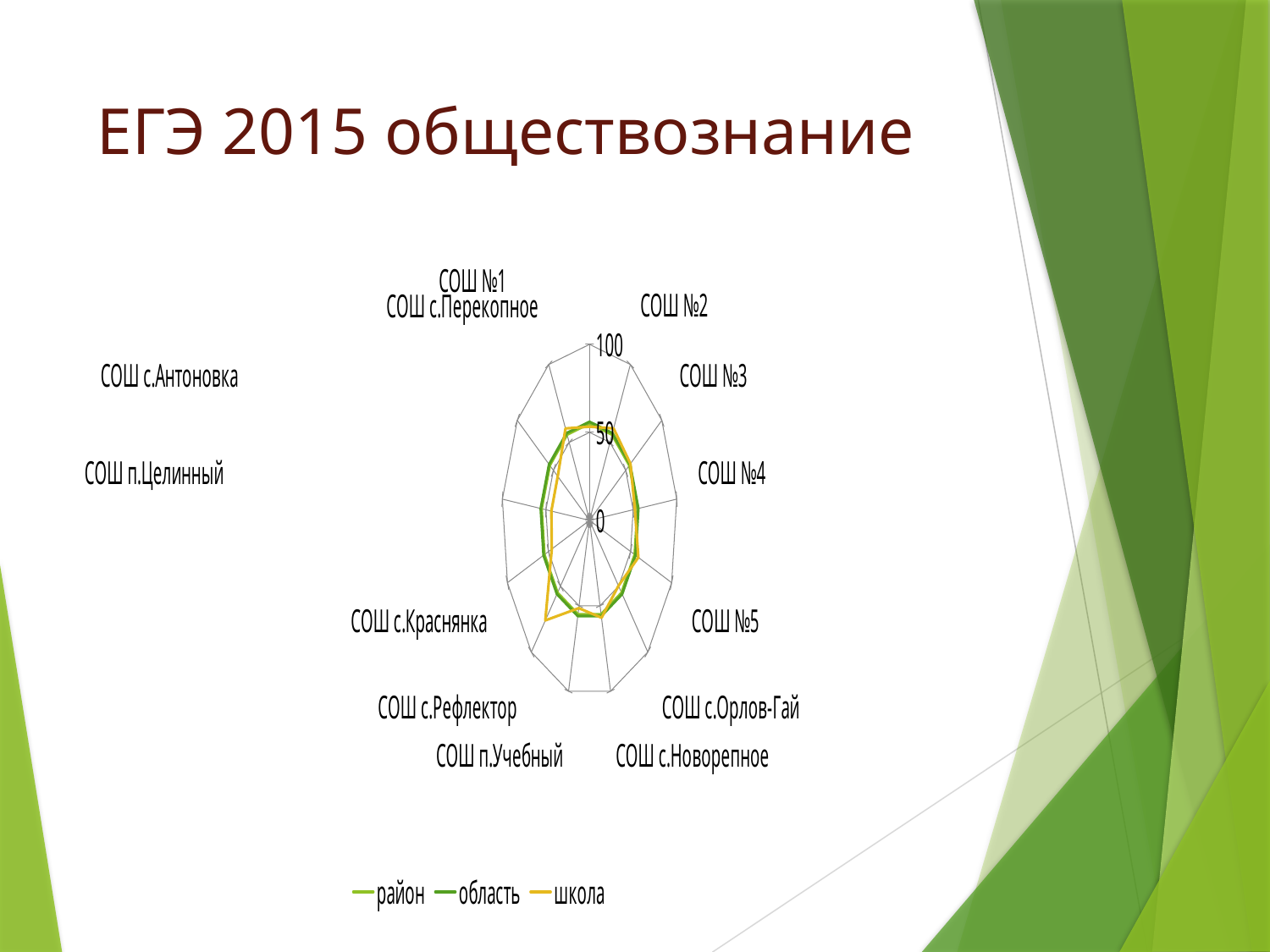
Is the value for школа at СОШ №4 greater or less than 100? less What kind of chart is shown on the slide? radar chart Is the value for область at СОШ №5 greater or less than 100? less Is the value for школа at СОШ с.Краснянка greater or less than 100? less What are the series names listed in the chart legend? район, область, школа What is the maximum value shown on the chart's axis? 100 What is the title of the slide containing the chart? ЕГЭ 2015 обществознание How many school categories are plotted around the radar chart? 13 How many series does the chart legend list? 3